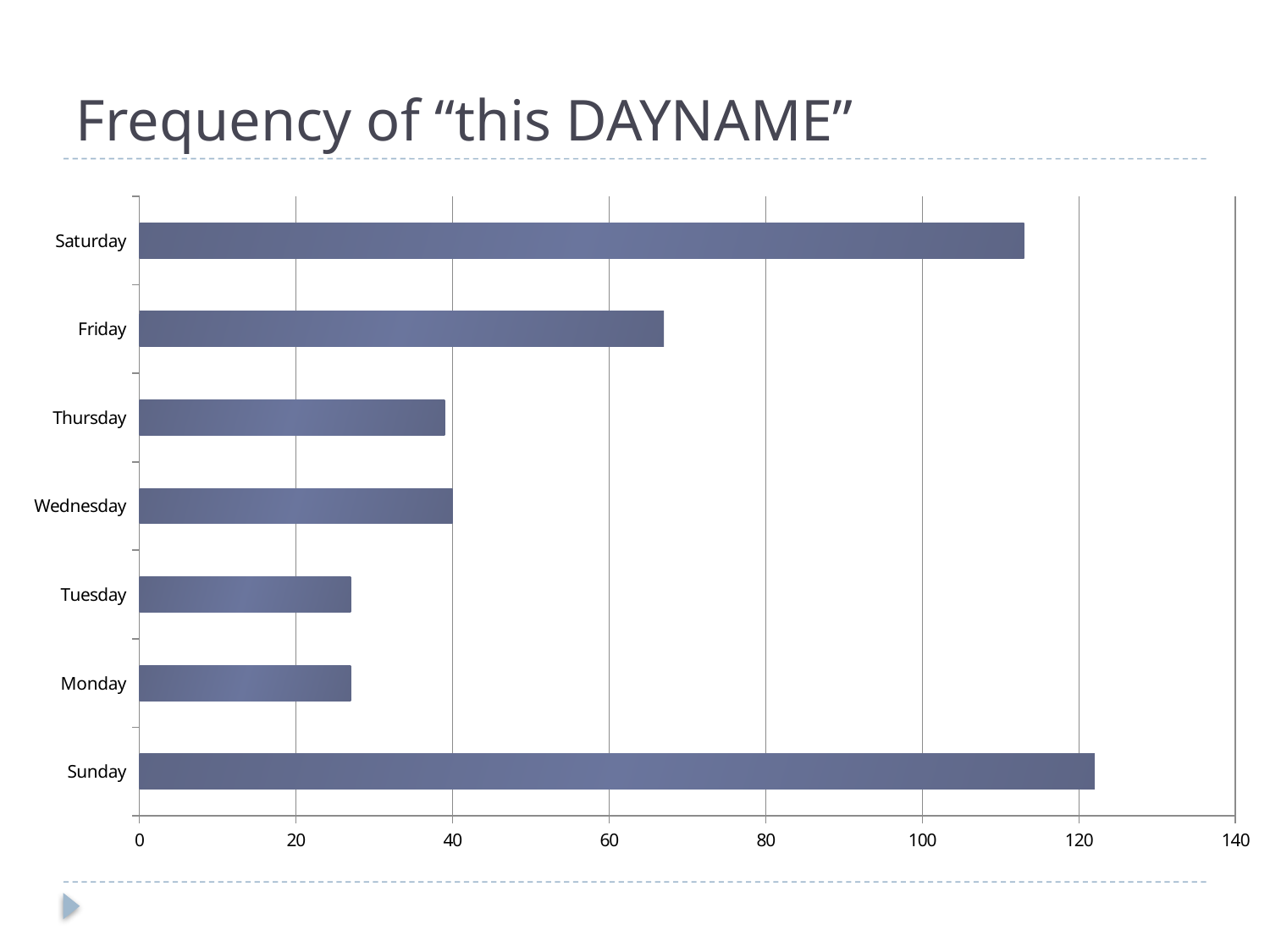
Which day has the highest value? Sunday How many days are plotted in the chart? 7 What kind of chart is shown on the slide? bar chart Which is larger, the value for Sunday or the value for Saturday? Sunday What is the maximum value shown on the horizontal axis? 140 Is the value for Tuesday greater or less than 20? greater Is the value for Friday greater or less than 60? greater What is the title of the chart? Frequency of “this DAYNAME” Which is larger, the value for Friday or the value for Thursday? Friday Is the value for Saturday greater or less than 100? greater